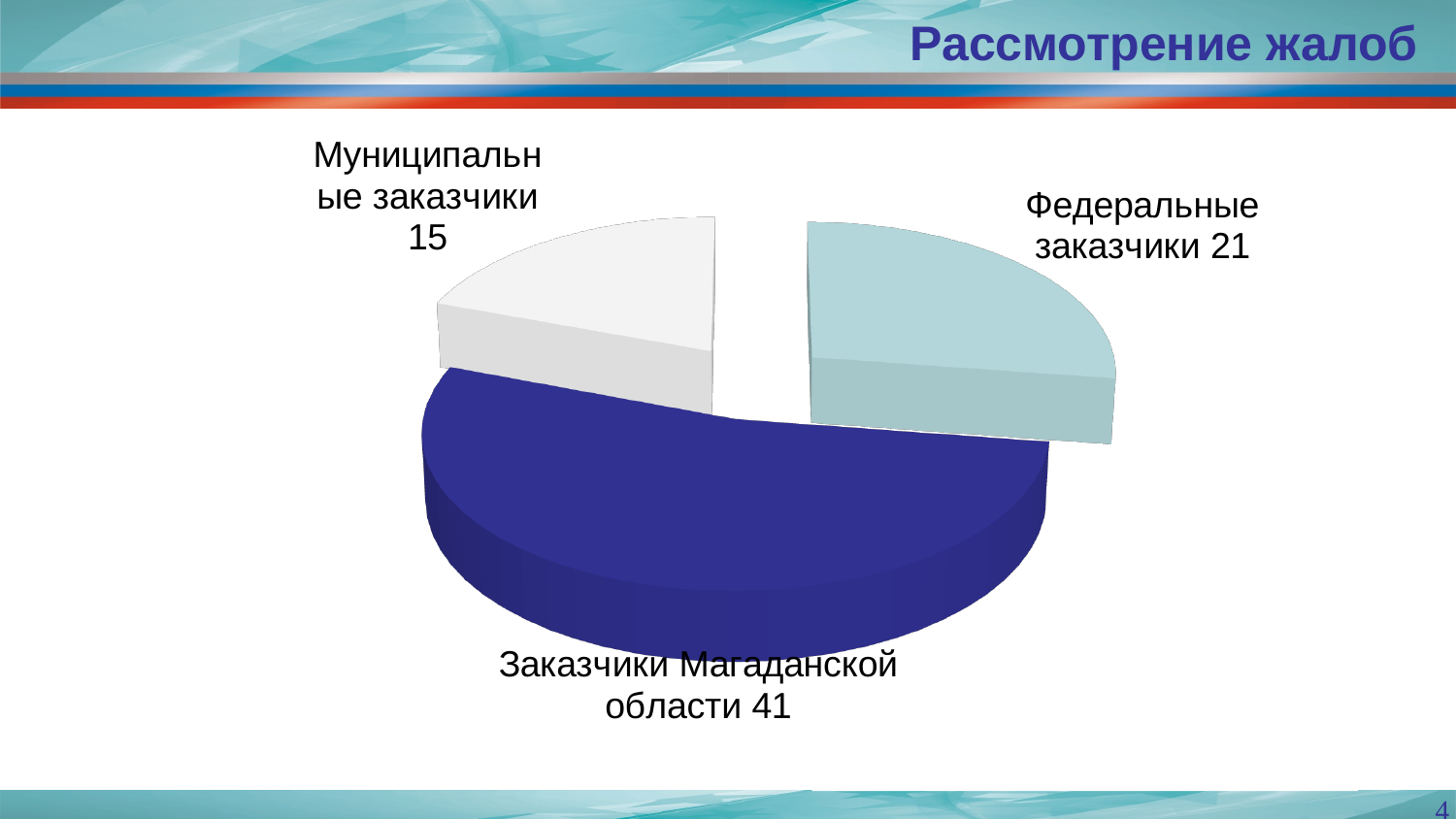
What is the value for Муниципальные заказчики? 15 What is the total of all three slices in the pie chart? 77 What is the difference between the values for Заказчики Магаданской области and Федеральные заказчики? 20 Which category has the smallest slice of the pie? Муниципальные заказчики What is the value for Заказчики Магаданской области? 41 What kind of chart is shown on the slide? pie chart Which is larger: the value for Федеральные заказчики or the value for Муниципальные заказчики? Федеральные заказчики Which category has the largest slice of the pie? Заказчики Магаданской области What is the difference between the values for Федеральные заказчики and Муниципальные заказчики? 6 What is the value for Федеральные заказчики? 21 What is the title of the slide containing the chart? Рассмотрение жалоб How many categories does the pie chart have? 3